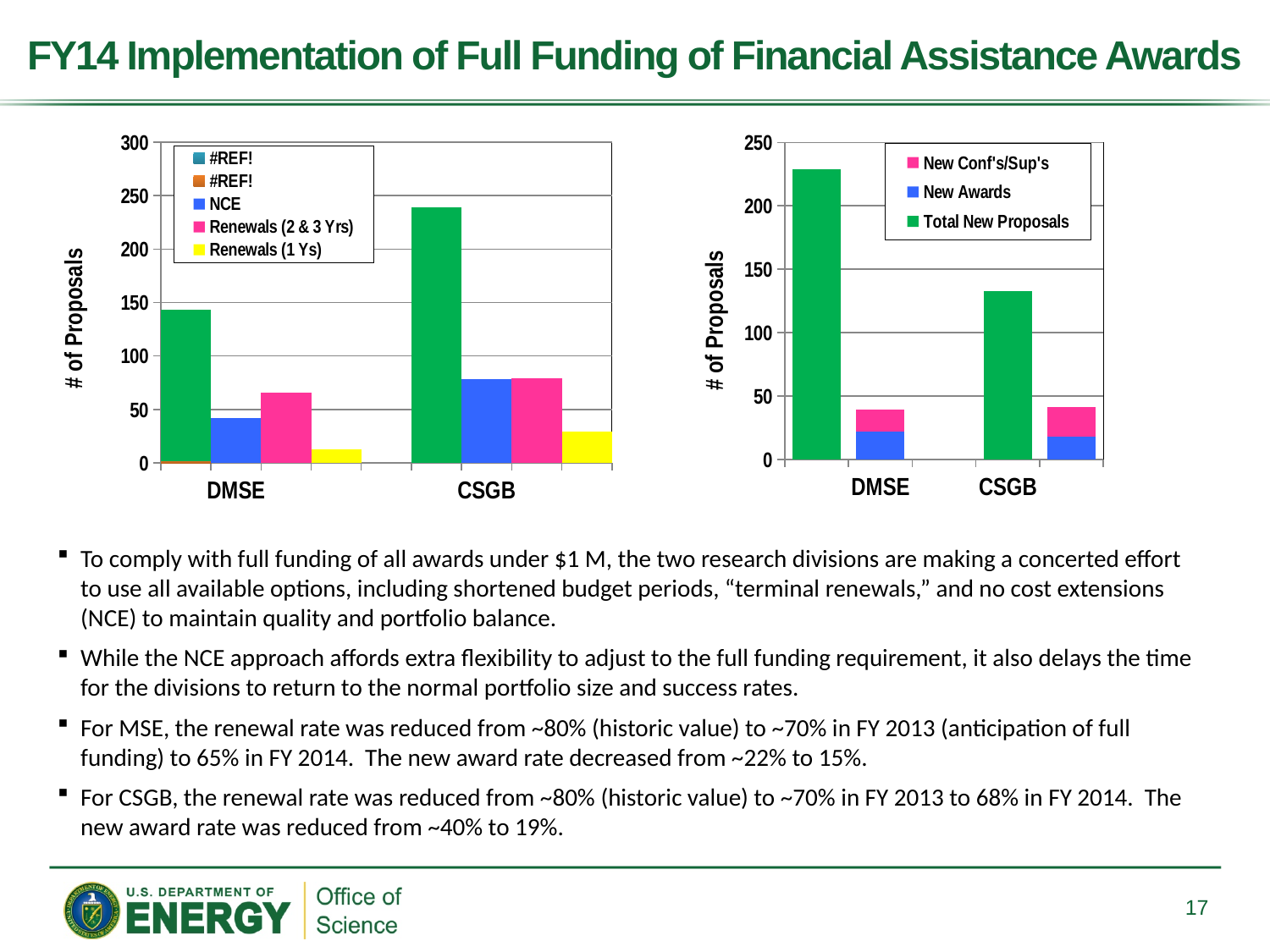
In the right chart, which category has the higher Total New Proposals value, DMSE or CSGB? DMSE In the right chart, is the Total New Proposals value for DMSE greater or less than 200? greater In the left chart, is the NCE value for CSGB greater or less than 50? greater In the left chart, is the Renewals (1 Ys) value for DMSE greater or less than 50? less How many categories are shown on the x axis of the left chart? 2 What kind of chart is the right chart? bar chart How many series does the legend of the right chart list? 3 What kind of chart is the left chart? bar chart In the left chart, which category has the higher Renewals (1 Ys) value, DMSE or CSGB? CSGB How many entries does the legend of the left chart list? 5